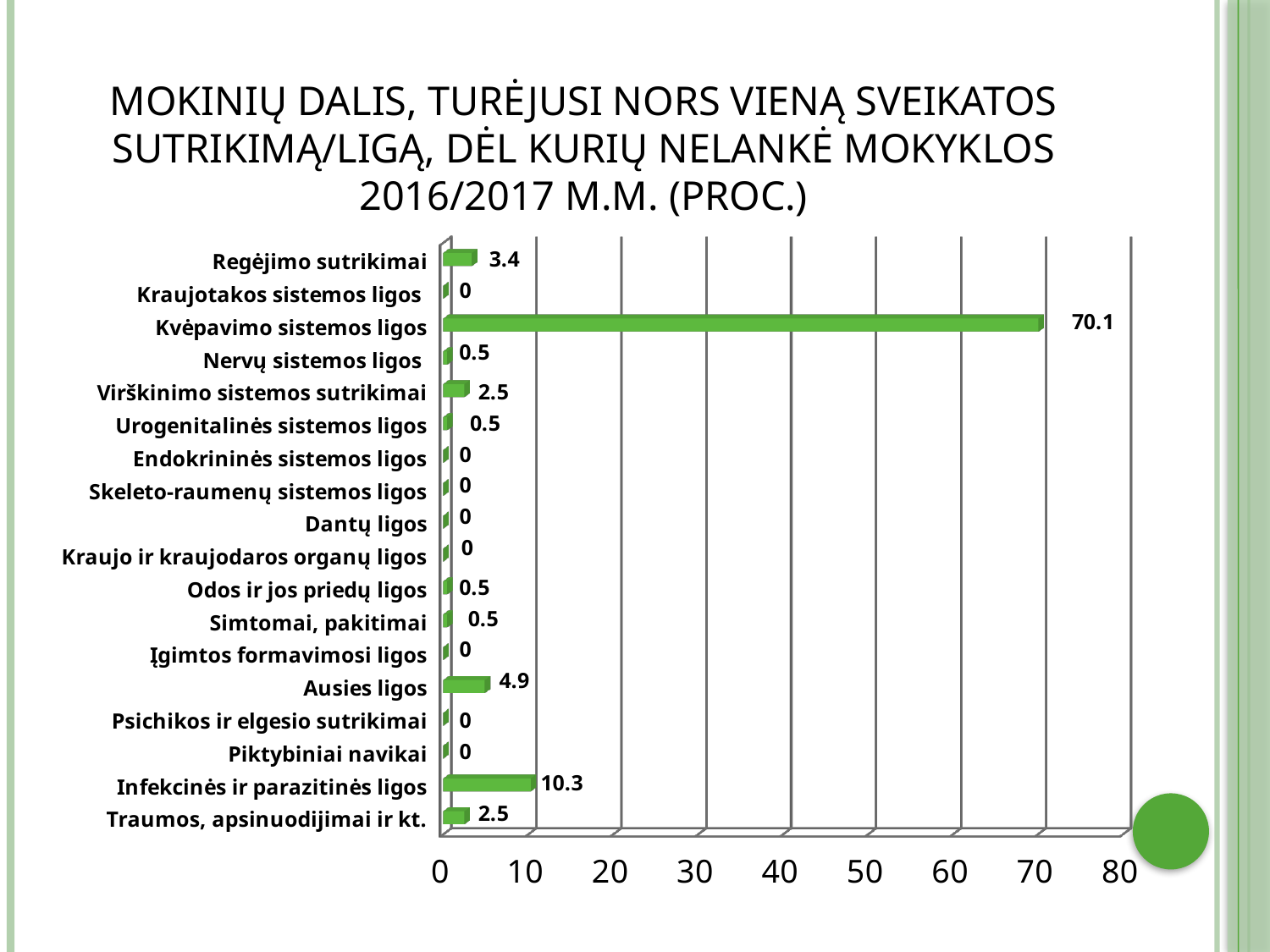
What is the value for Kvėpavimo sistemos ligos? 70.1 What is the value for Traumos, apsinuodijimai ir kt.? 2.5 What is the difference between the values for Ausies ligos and Regėjimo sutrikimai? 1.5 Is the value for Kvėpavimo sistemos ligos greater or less than 60? greater How many categories are shown on the chart? 18 Which category has the highest value? Kvėpavimo sistemos ligos What kind of chart is shown on the slide? bar chart What is the value for Infekcinės ir parazitinės ligos? 10.3 What is the value for Ausies ligos? 4.9 Which is larger, the value for Infekcinės ir parazitinės ligos or the value for Ausies ligos? Infekcinės ir parazitinės ligos What is the value for Regėjimo sutrikimai? 3.4 What is the difference between the values for Kvėpavimo sistemos ligos and Infekcinės ir parazitinės ligos? 59.8